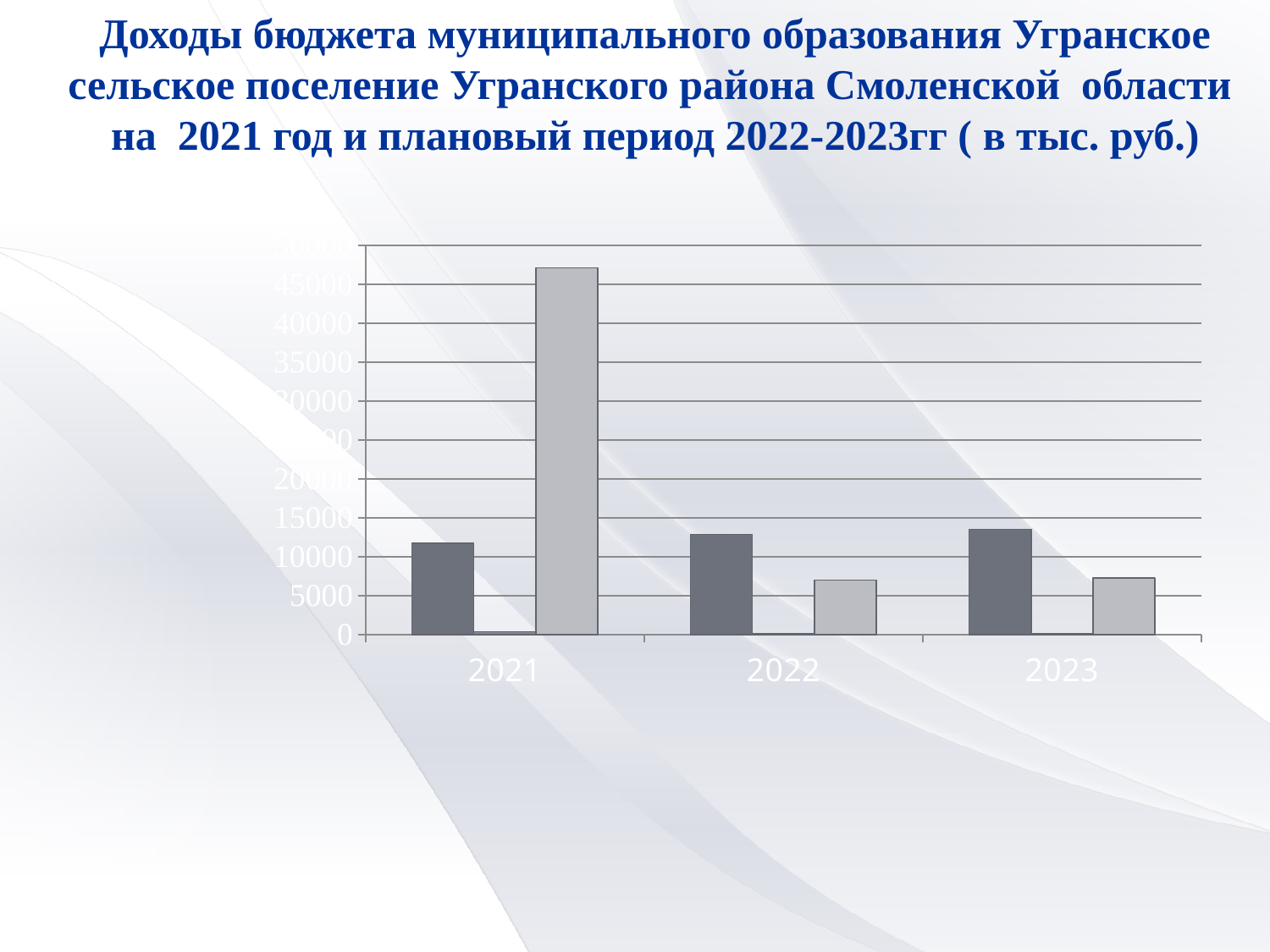
Is the value of the tallest (light grey) bar for 2021 greater or less than 45000? greater What kind of chart is shown on the slide? bar chart Is the value of the dark grey bar for 2021 greater or less than 15000? less Which is larger: the light grey bar for 2021 or the light grey bar for 2022? the light grey bar for 2021 How many year categories are shown on the x axis of the chart? 3 Which year has the tallest bar on the chart? 2021 Is the value of the dark grey bar for 2023 greater or less than 10000? greater Do the dark grey bars rise or fall from 2021 to 2023? rise Which is larger for 2022: the dark grey bar or the light grey bar? the dark grey bar In what units are the values on the chart expressed, according to the slide title? тыс. руб. How many bars are plotted for each year on the chart? 3